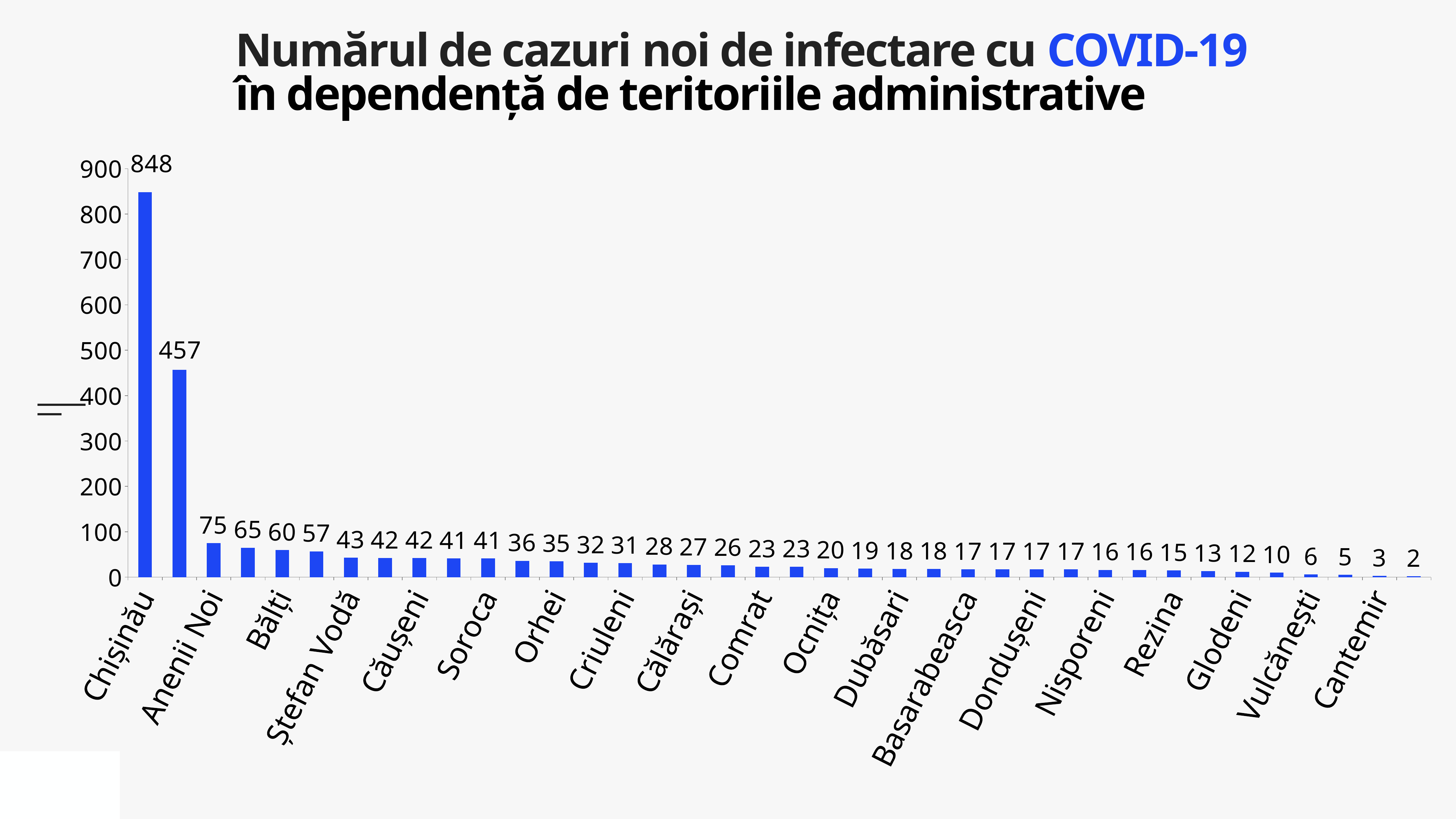
What colour are the bars in the chart? blue Do the values rise or fall from left to right along the x axis? fall What is the value shown for Anenii Noi? 75 What is the value shown for Bălți? 60 Is the value for Chișinău greater or less than 800? greater Which has a larger value, Chișinău or Anenii Noi? Chișinău Which territory has the highest number of new COVID-19 cases? Chișinău What is the difference between the values for Chișinău and Anenii Noi? 773 What is the highest value marked on the vertical axis? 900 What type of chart is shown on the slide? bar chart Is the value for Bălți greater or less than 100? less What is the value shown for Chișinău? 848